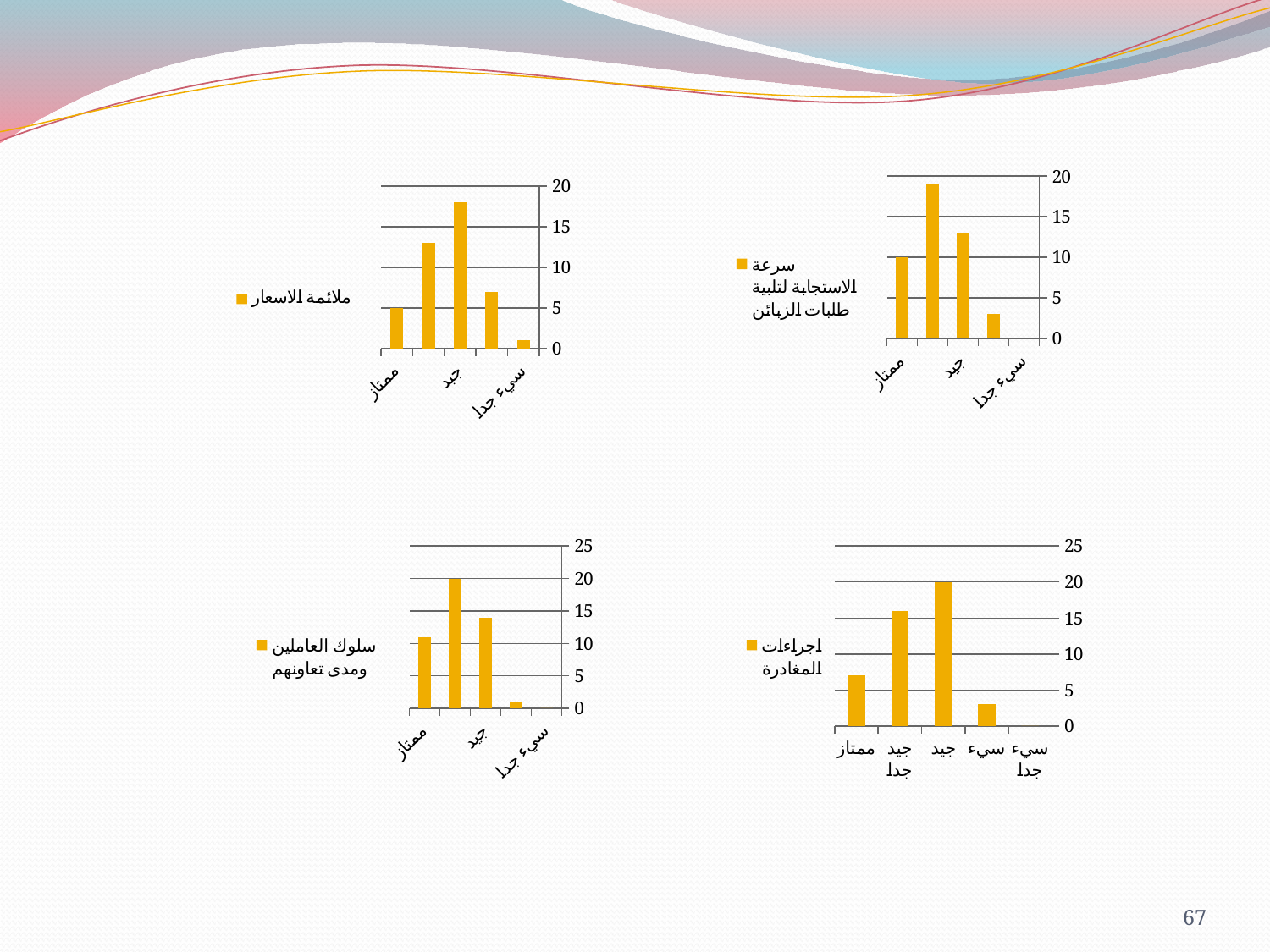
How many bars are plotted in the top-left chart (ملائمة الاسعار)? 5 In the top-left chart (ملائمة الاسعار), which category has the highest bar? جيد In the top-left chart (ملائمة الاسعار), which category has the lowest bar? سيء جدا In the top-right chart (سرعة الاستجابة لتلبية طلبات الزبائن), is the value for سيء جدا greater or less than 5? less In the bottom-right chart (اجراءات المغادرة), is the value for ممتاز greater or less than 10? less In the top-right chart (سرعة الاستجابة لتلبية طلبات الزبائن), is the value for ممتاز greater or less than 5? greater In the bottom-right chart (اجراءات المغادرة), which is larger, the value for جيد or the value for ممتاز? جيد What kind of chart is the top-right chart (سرعة الاستجابة لتلبية طلبات الزبائن)? Bar chart What legend entry is shown for the bottom-right chart? اجراءات المغادرة How many bars are plotted in the bottom-left chart (سلوك العاملين ومدى تعاونهم)? 4 How many series does the legend of the top-left chart (ملائمة الاسعار) list? 1